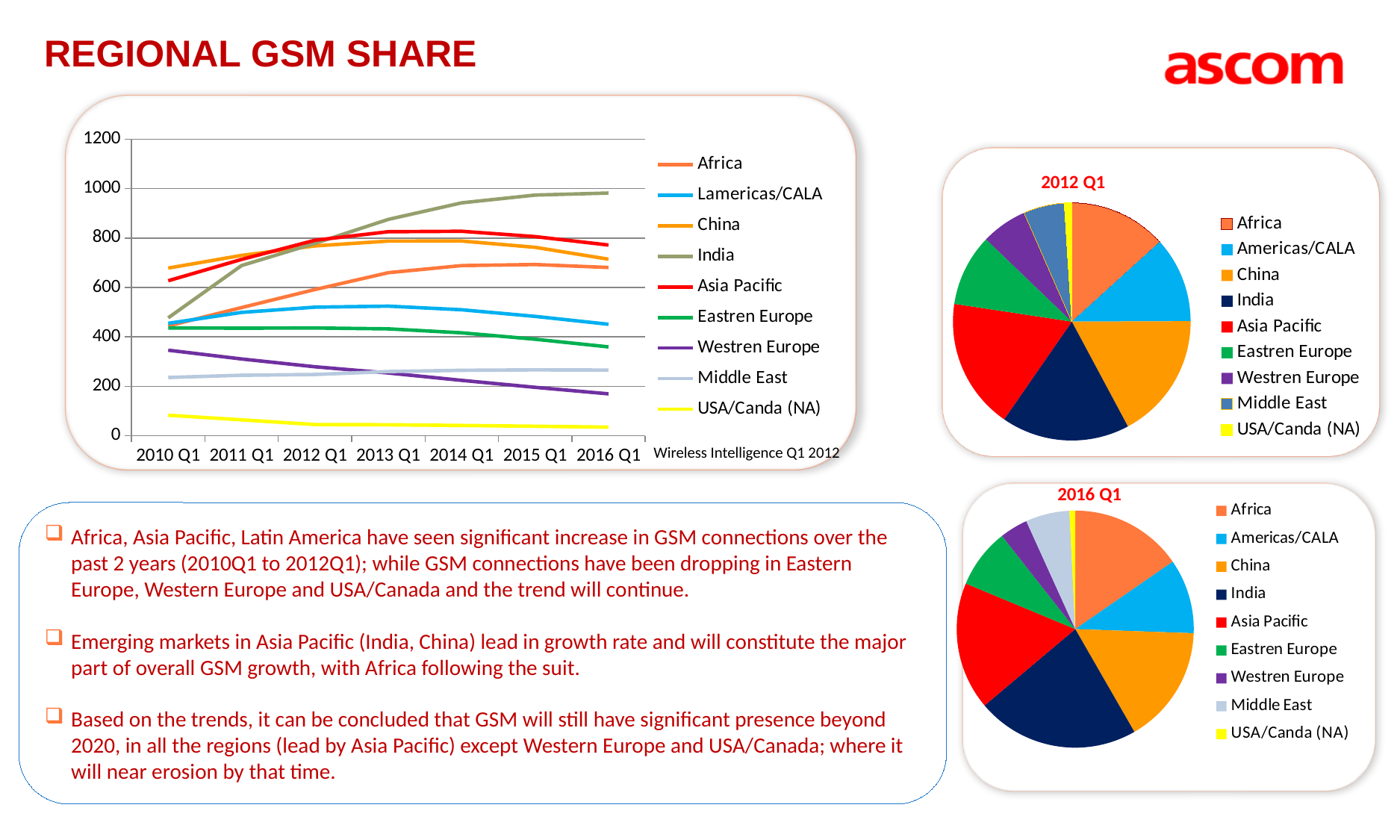
In the line chart on the left, does the Westren Europe series rise or fall from 2010 Q1 to 2016 Q1? fall In the line chart on the left, does the India series rise or fall from 2010 Q1 to 2016 Q1? rise In the line chart on the left, which series has the highest value at 2016 Q1? India In the line chart on the left, is the value for USA/Canda (NA) at 2010 Q1 greater or less than 200? less How many series does the legend of the line chart on the left list? 9 What kind of chart is the chart titled 2016 Q1? pie chart In the line chart on the left, which series has the lowest value at 2016 Q1? USA/Canda (NA) What kind of chart is the chart on the left of the slide? line chart In the line chart on the left, which is larger at 2010 Q1: China or Africa? China In the line chart on the left, is the value for India at 2016 Q1 greater or less than 800? greater How many points are on the x axis of the line chart on the left? 7 In the pie chart titled 2016 Q1, which category has the largest slice? India